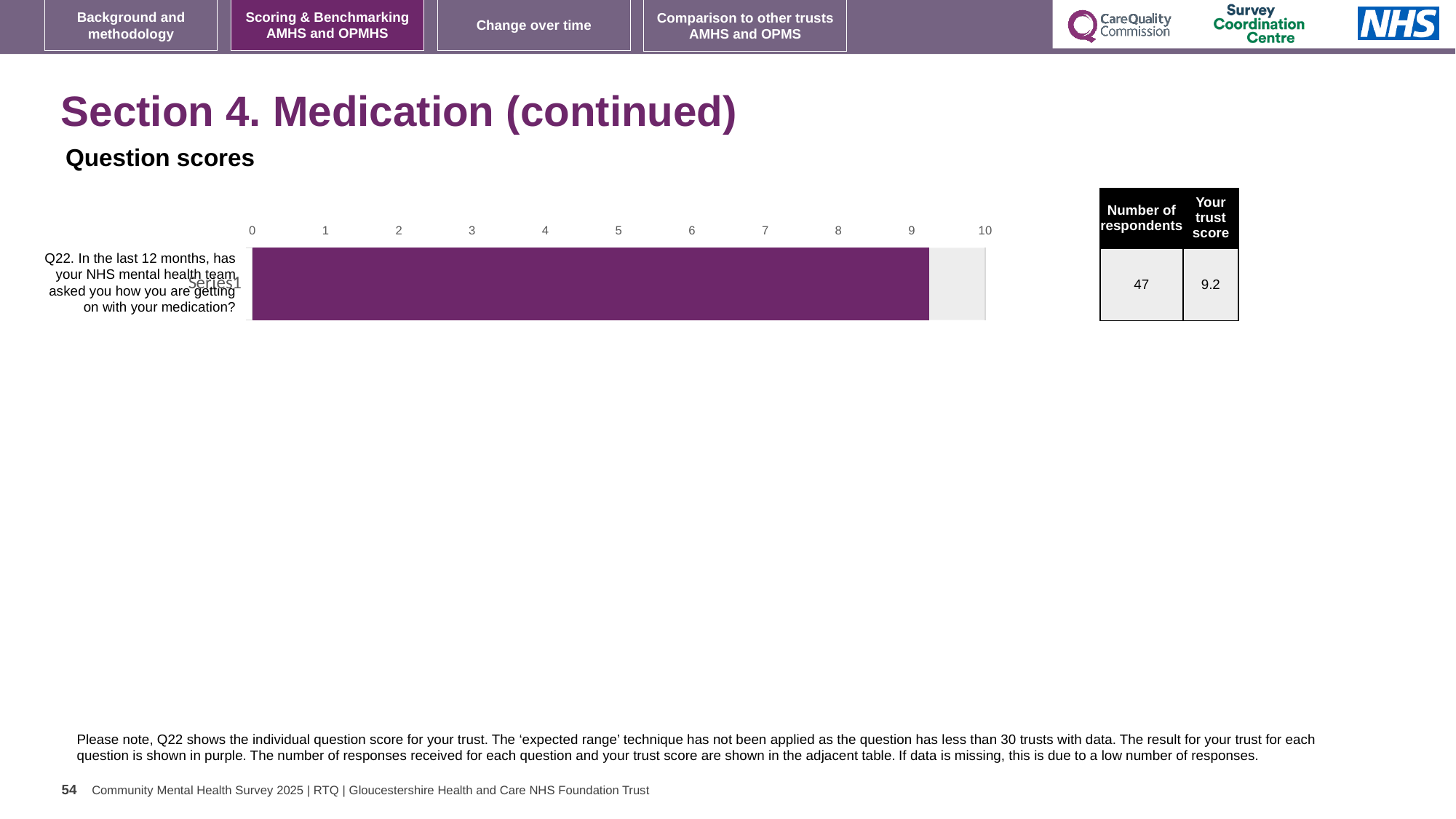
How many respondents answered Q22 according to the table next to the chart? 47 Which question number is plotted in the chart? Q22 What colour is the bar representing the trust's score for Q22? purple How many questions (categories) are plotted in the bar chart? 1 Is the bar value for Q22 greater or less than 5? greater What is the trust score for Q22 shown in the adjacent table? 9.2 Is the bar value for Q22 greater or less than 8? greater What is the maximum value shown on the chart's horizontal axis? 10 What kind of chart is shown on the slide? bar chart